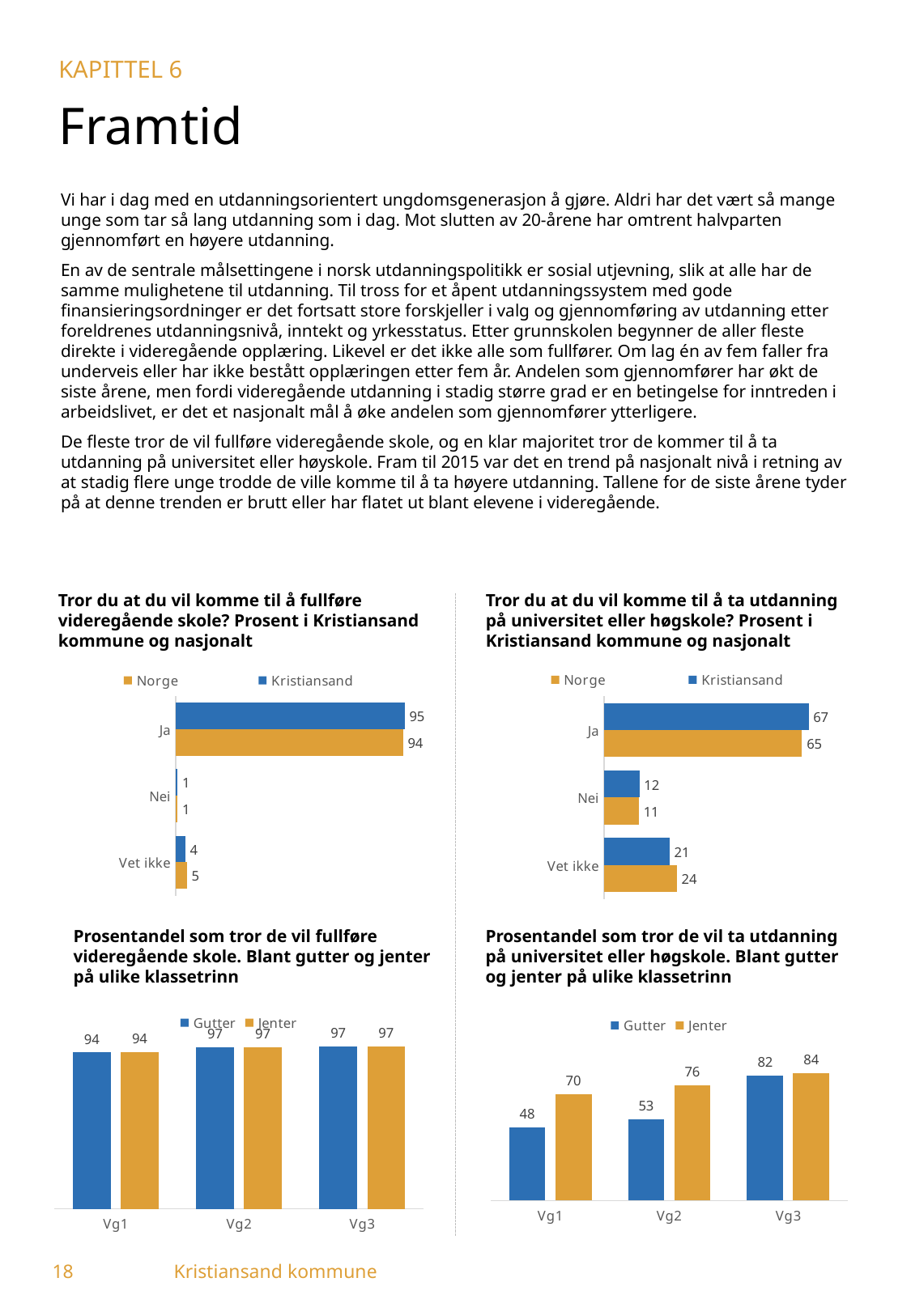
In the top-right chart (Tror du at du vil komme til å ta utdanning på universitet eller høgskole?), how many series does the legend list? 2 In the bottom-right chart (Prosentandel som tror de vil ta utdanning på universitet eller høgskole), what is the difference between Jenter and Gutter at Vg2? 23 In the bottom-right chart (Prosentandel som tror de vil ta utdanning på universitet eller høgskole), what is the value for Gutter at Vg1? 48 In the bottom-right chart (Prosentandel som tror de vil ta utdanning på universitet eller høgskole), how many class levels are shown on the x axis? 3 In the top-right chart (Tror du at du vil komme til å ta utdanning på universitet eller høgskole?), which category has the lowest value for Kristiansand? Nei What kind of chart is the bottom-left chart (Prosentandel som tror de vil fullføre videregående skole)? Bar chart In the top-left chart (Tror du at du vil komme til å fullføre videregående skole?), what is the value for Kristiansand for 'Ja'? 95 In the bottom-right chart (Prosentandel som tror de vil ta utdanning på universitet eller høgskole), do the values for Gutter rise or fall from Vg1 to Vg3? Rise In the top-right chart (Tror du at du vil komme til å ta utdanning på universitet eller høgskole?), what is the value for Norge for 'Ja'? 65 In the top-right chart (Tror du at du vil komme til å ta utdanning på universitet eller høgskole?), what is the difference between Norge and Kristiansand for 'Vet ikke'? 3 In the top-left chart (Tror du at du vil komme til å fullføre videregående skole?), what is the value for Norge for 'Vet ikke'? 5 In the bottom-left chart (Prosentandel som tror de vil fullføre videregående skole), what is the value for Jenter at Vg1? 94